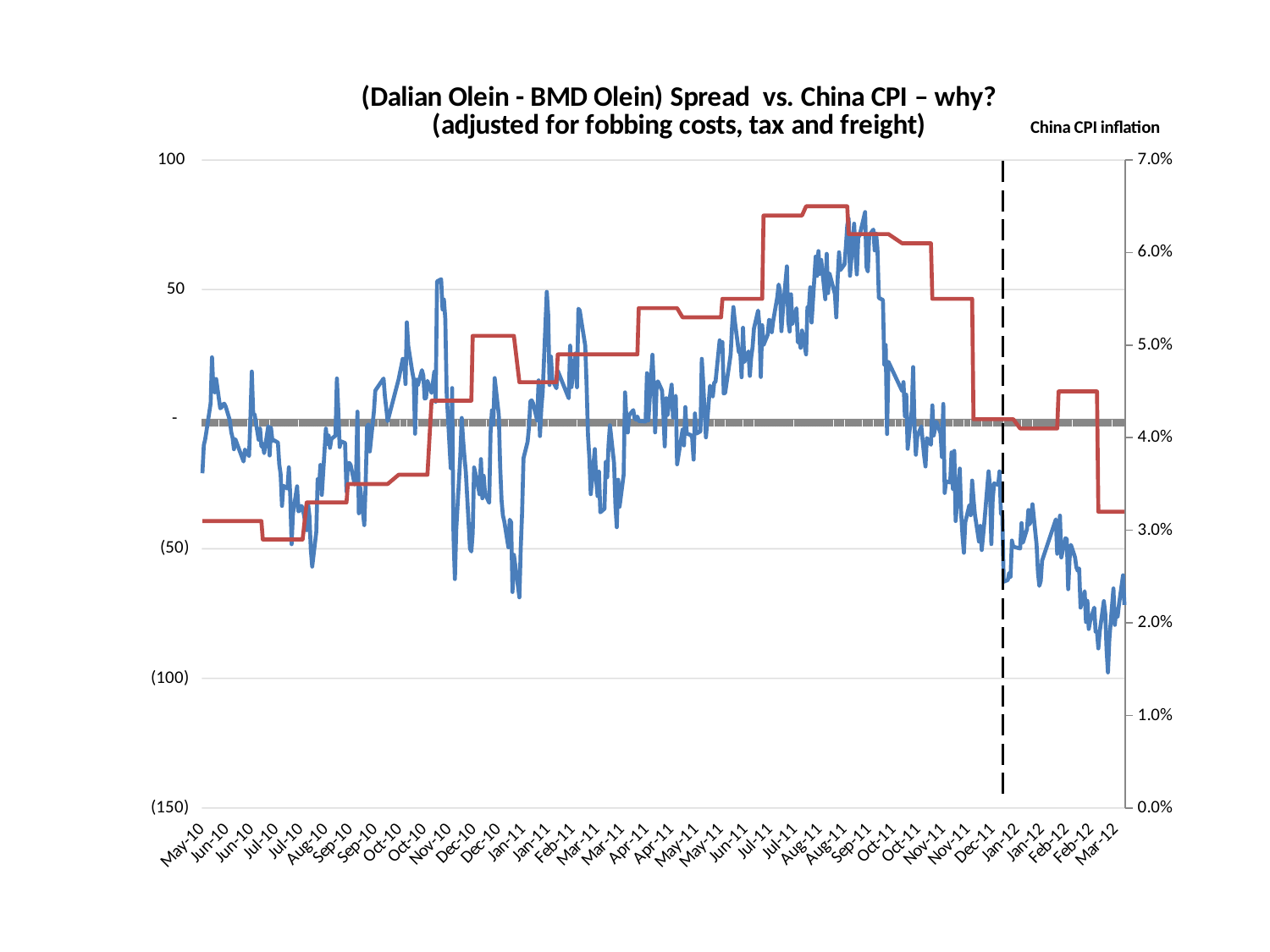
Is the red China CPI inflation line at Mar-12 greater or less than 4.0%? less What is the title of the chart? (Dalian Olein - BMD Olein) Spread vs. China CPI – why? (adjusted for fobbing costs, tax and freight) Does the blue spread line rise or fall overall between Oct-11 and Feb-12? fall Does the red China CPI inflation line rise or fall between Nov-11 and Mar-12? fall What kind of chart is shown on the slide? Line chart Is the blue spread line at its lowest point around Feb-12 greater or less than (50)? less Which is larger for the red China CPI inflation line: the value around Aug-11 or the value around May-10? Aug-11 Is the blue spread line at its peak around Sep-11 greater or less than 50? greater What is the highest value shown on the right-hand axis? 7.0% What label is shown above the right-hand axis of the chart? China CPI inflation